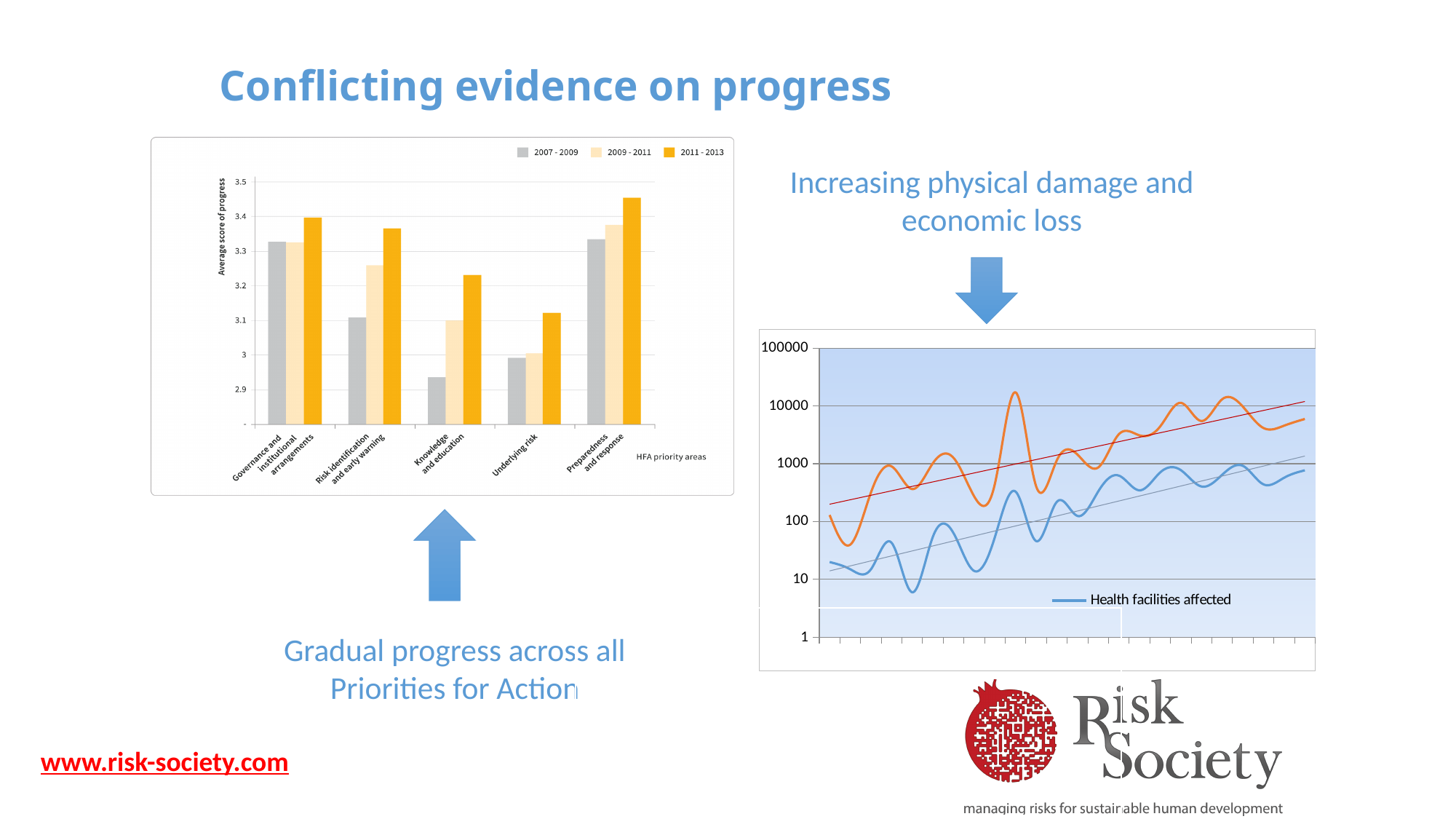
In the left bar chart, is the 2007 - 2009 value for Knowledge and education greater or less than 3? less In the left bar chart, what is the label of the y axis? Average score of progress In the left bar chart, is the 2011 - 2013 value for Governance and institutional arrangements greater or less than 3.3? greater In the left bar chart, which HFA priority area has the highest 2011 - 2013 bar? Preparedness and response What kind of chart is the left chart showing average score of progress by HFA priority area? bar chart In the right line chart, do the plotted lines generally rise or fall from left to right? rise In the left bar chart, which is larger for Risk identification and early warning: the 2007 - 2009 value or the 2011 - 2013 value? 2011 - 2013 What kind of chart is the right chart under the heading 'Increasing physical damage and economic loss'? line chart In the left bar chart, how many series does the legend list? 3 In the left bar chart, which HFA priority area has the lowest 2007 - 2009 bar? Knowledge and education In the left bar chart, how many HFA priority areas are shown on the x axis? 5 In the right line chart, what series name is shown in the legend? Health facilities affected